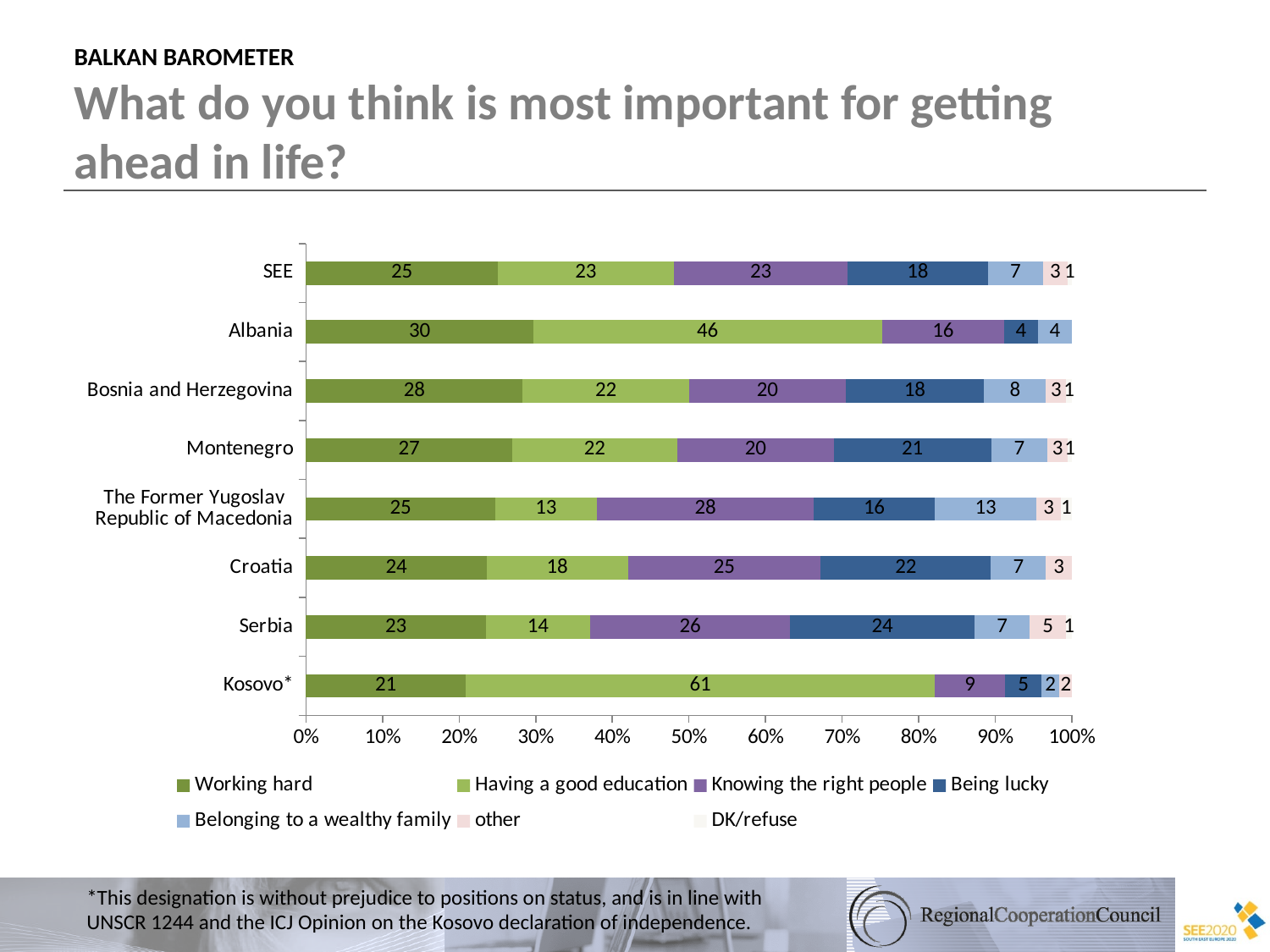
What is the difference between the 'Having a good education' values for Kosovo* and Albania? 15 Which country has the highest value for 'Having a good education'? Kosovo* What is the title of the chart on the slide? What do you think is most important for getting ahead in life? What is the value for 'Working hard' in Bosnia and Herzegovina? 28 What is the value for 'Knowing the right people' in The Former Yugoslav Republic of Macedonia? 28 How many series does the legend list? 7 What type of chart is shown on the slide? Stacked bar chart What percentage of respondents in Albania chose 'Having a good education'? 46 How many countries or regions are shown on the chart? 8 What is the value for 'Being lucky' in Serbia? 24 Which is larger: 'Being lucky' in Croatia or 'Being lucky' in Montenegro? Croatia Which country has the lowest value for 'Working hard'? Kosovo*